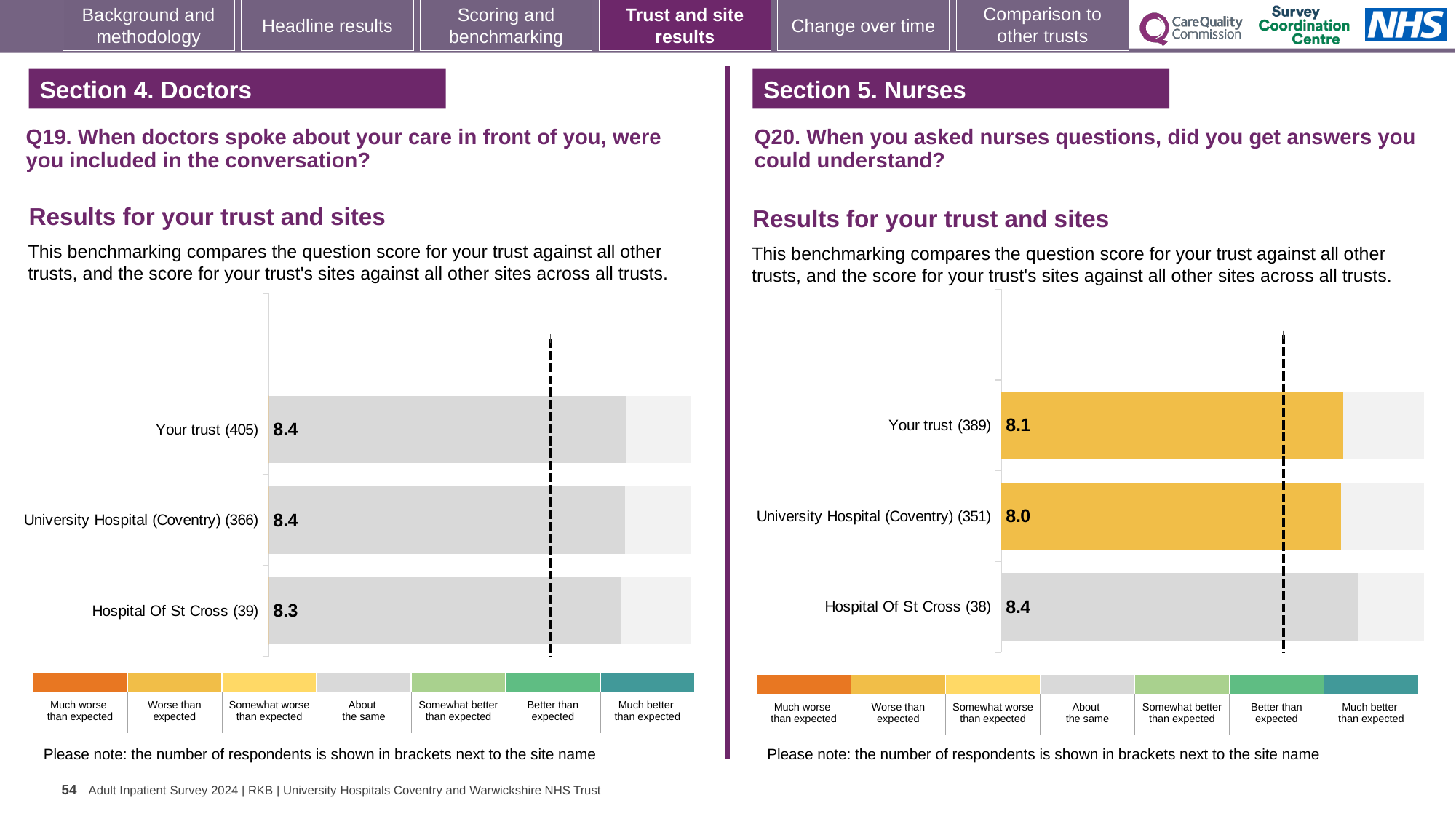
On the Q19 chart (left), what is the difference between the scores for Your trust and Hospital Of St Cross? 0.1 On the Q20 chart (right), what is the score for Your trust? 8.1 On the Q20 chart (right), what is the difference between the scores for Hospital Of St Cross and University Hospital (Coventry)? 0.4 On the Q20 chart (right), is the score for Your trust larger or smaller than the score for Hospital Of St Cross? smaller On the Q19 chart (left), which has the lowest score? Hospital Of St Cross On the Q20 chart (right), which site or trust has the highest score? Hospital Of St Cross On the Q19 chart (left), what is the score for Your trust? 8.4 What type of chart is used for the Q20 results (right)? bar chart On the Q20 chart (right), which site or trust has the lowest score? University Hospital (Coventry) On the Q19 chart (left), what is the score for Hospital Of St Cross? 8.3 How many bars are shown on the Q19 chart (left)? 3 On the Q20 chart (right), what is the score for University Hospital (Coventry)? 8.0